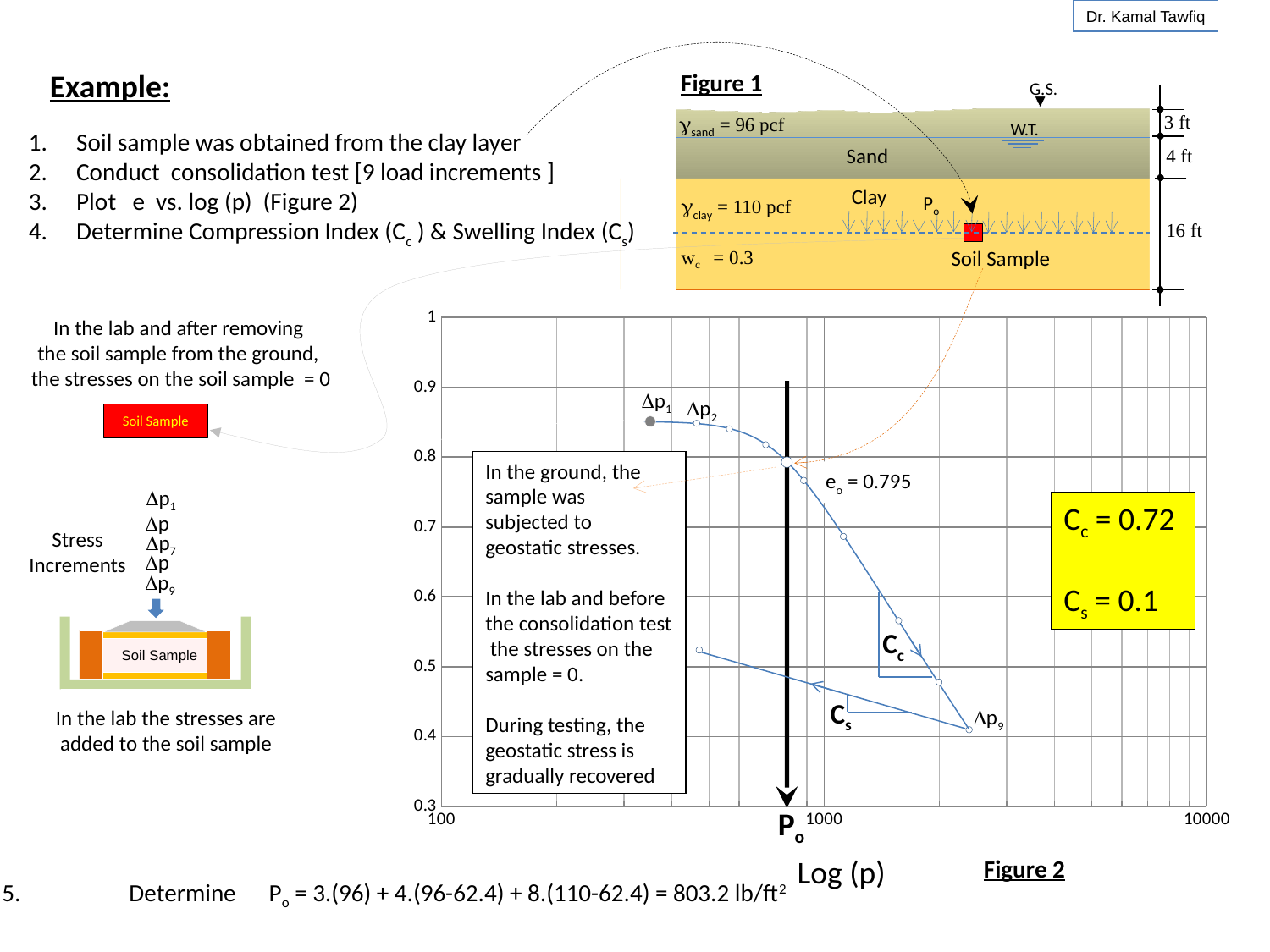
What is the difference between C_c and C_s as given on the slide? 0.62 What kind of chart is Figure 2? line chart In Figure 2, what is the value of the Swelling Index C_s shown on the slide? 0.1 In Figure 2, is the void ratio at Δp1 greater or less than 0.8? greater In Figure 2, is the void ratio at Δp9 greater or less than 0.5? less In Figure 2, what is the label of the x axis? Log (p) In Figure 2, what is the value of the Compression Index C_c shown on the slide? 0.72 What is the value of P_o computed on the slide? 803.2 lb/ft² How many load increments were applied in the consolidation test plotted in Figure 2? 9 In Figure 2, what is the value of the initial void ratio e_o marked on the curve? 0.795 In Figure 2, does the void ratio e rise or fall along the loading curve as log(p) increases? fall Which is larger, the Compression Index C_c or the Swelling Index C_s? C_c